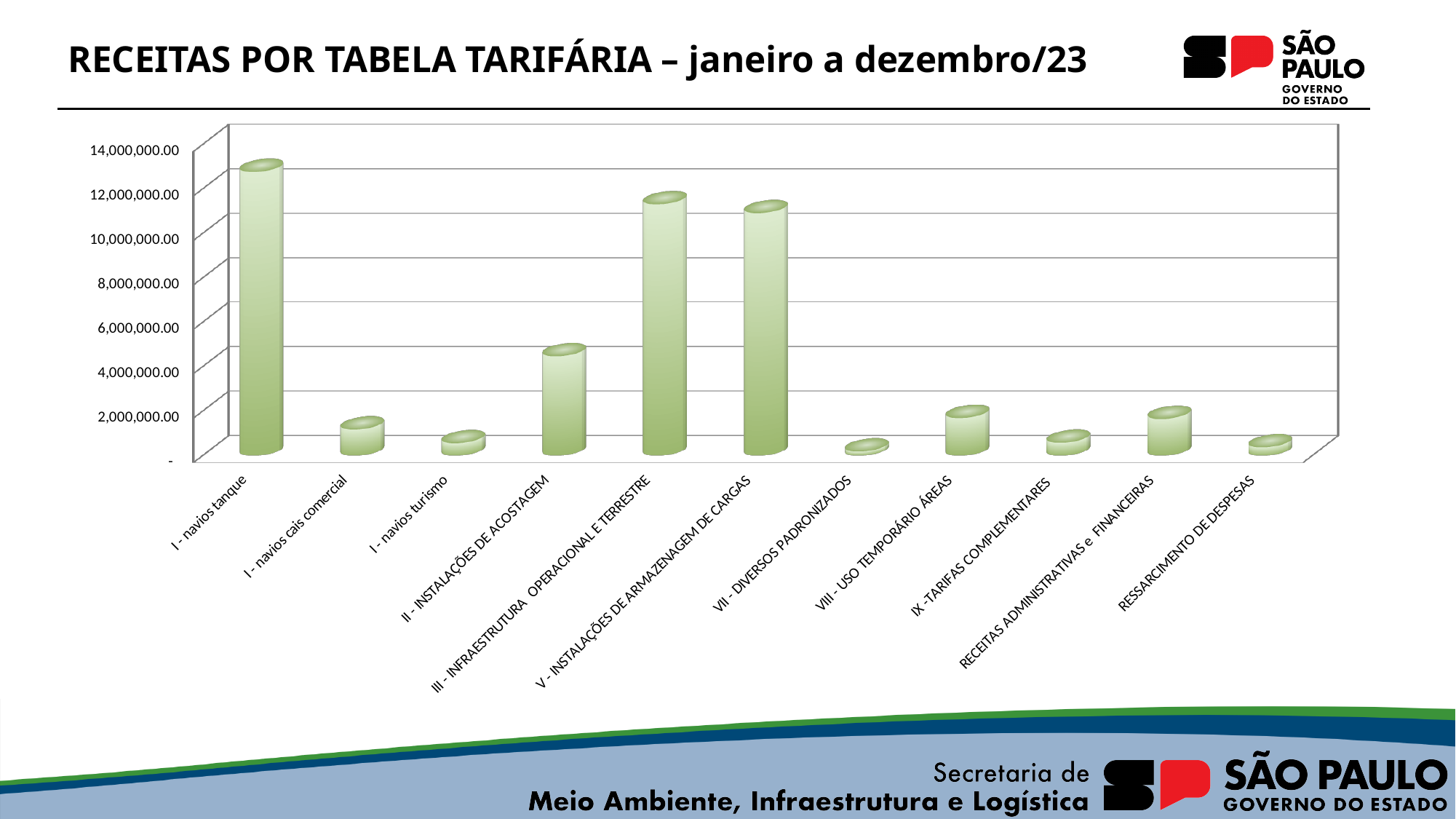
What is the highest value shown on the vertical axis of the chart? 14,000,000.00 How many categories are plotted on the chart? 11 Which is larger, the value for I - navios tanque or the value for V - INSTALAÇÕES DE ARMAZENAGEM DE CARGAS? I - navios tanque Is the value for I - navios tanque greater or less than 12,000,000.00? greater Which category has the lowest value on the chart? VII - DIVERSOS PADRONIZADOS Which category has the highest value on the chart? I - navios tanque Is the value for VIII - USO TEMPORÁRIO ÁREAS greater or less than 4,000,000.00? less Is the value for III - INFRAESTRUTURA OPERACIONAL E TERRESTRE greater or less than 10,000,000.00? greater What kind of chart is shown on the slide? bar chart What is the title of the slide containing the chart? RECEITAS POR TABELA TARIFÁRIA – janeiro a dezembro/23 Which is larger, the value for II - INSTALAÇÕES DE ACOSTAGEM or the value for I - navios cais comercial? II - INSTALAÇÕES DE ACOSTAGEM